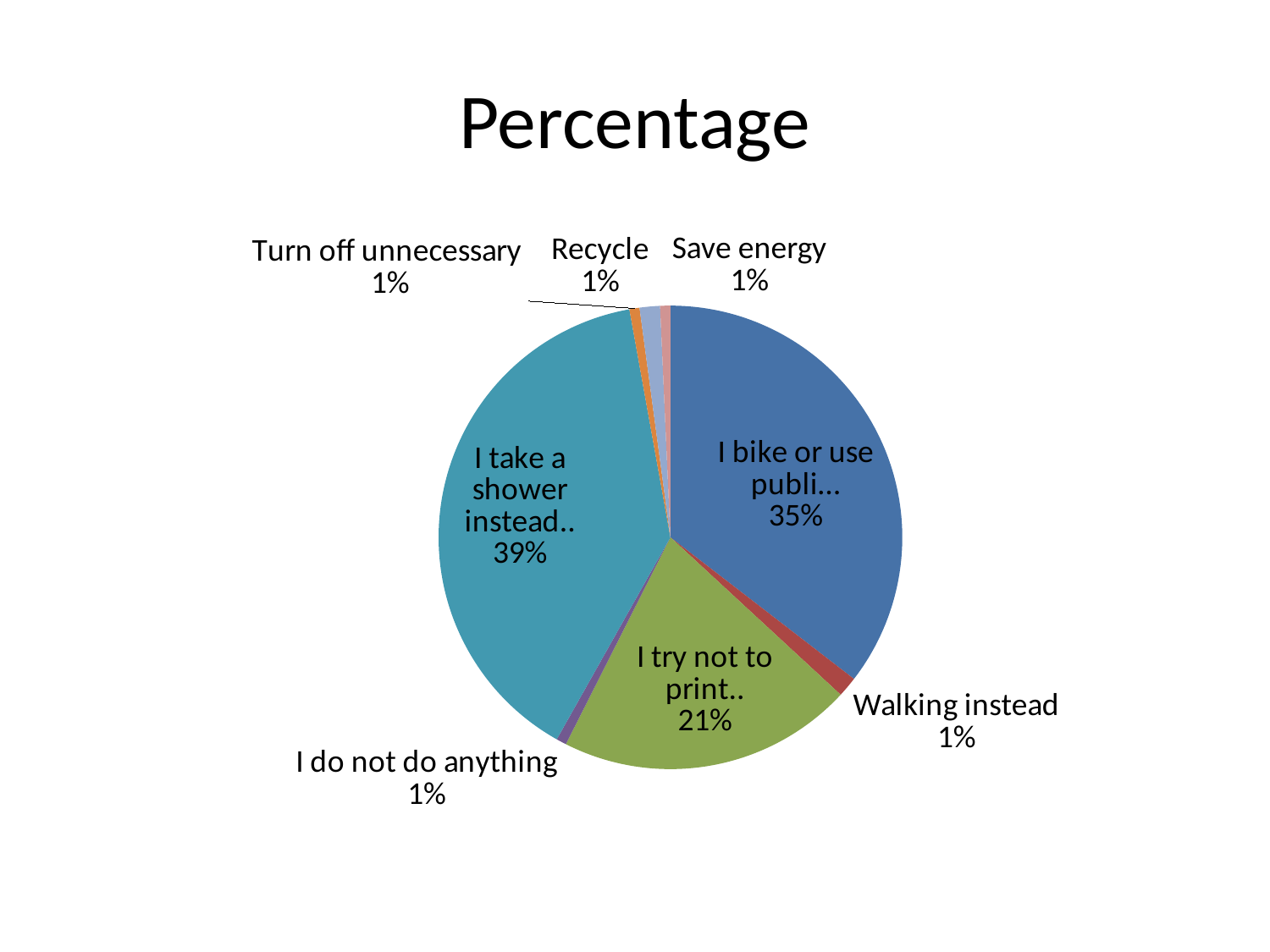
What share of the pie does the "I take a shower instead.." slice have? 39% What percentage is shown for "I try not to print.."? 21% Which slice of the pie is the largest? I take a shower instead.. How many slices are labelled 1%? 5 What percentage is shown for the "I bike or use publi…" slice? 35% Which is larger, the "I bike or use publi…" slice or the "I try not to print.." slice? I bike or use publi… What percentage is shown for "Walking instead"? 1% What kind of chart is shown on the slide? pie chart What is the title of the chart? Percentage What is the difference in percentage points between "I take a shower instead.." and "I bike or use publi…"? 4 What percentage is shown for "Recycle"? 1% How many slices does the pie chart have? 8